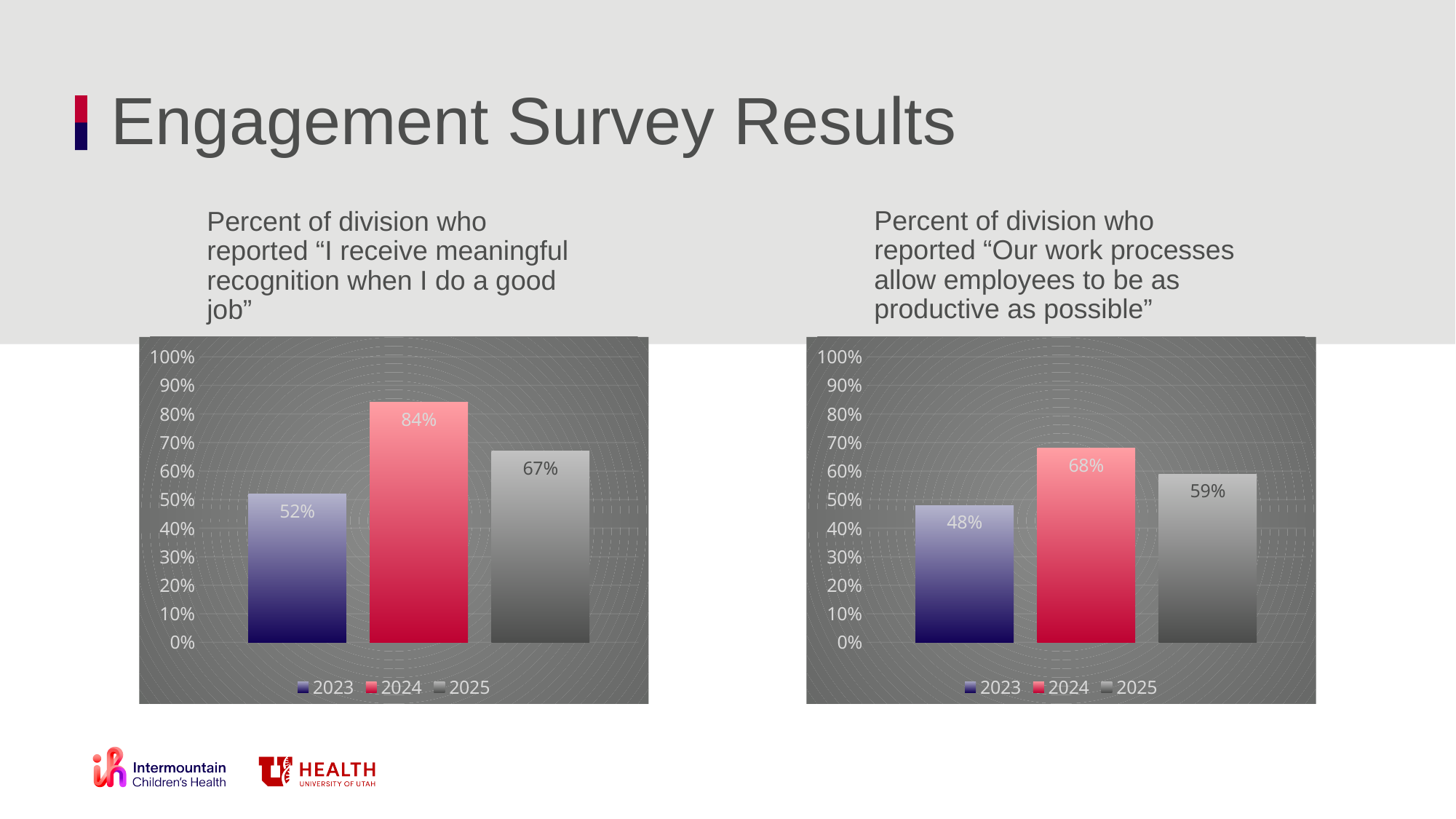
In the right chart (work processes), what is the value for 2023? 48% In the left chart (meaningful recognition), which year has the highest value? 2024 In the right chart (work processes), what is the difference between the 2024 and 2023 values? 20% In the left chart (meaningful recognition), is the value for 2025 greater or less than 60%? greater In the right chart (work processes), which year has the lowest value? 2023 In the left chart (meaningful recognition), what is the value for 2024? 84% How many series does the legend of the left chart list? 3 In the right chart (work processes), what is the value for 2025? 59% In the left chart (meaningful recognition), what is the difference between the 2024 and 2025 values? 17% In the left chart (meaningful recognition), what is the value for 2023? 52% In the right chart (work processes), which is larger, the value for 2024 or the value for 2025? 2024 What kind of chart is the right chart (work processes)? Bar chart